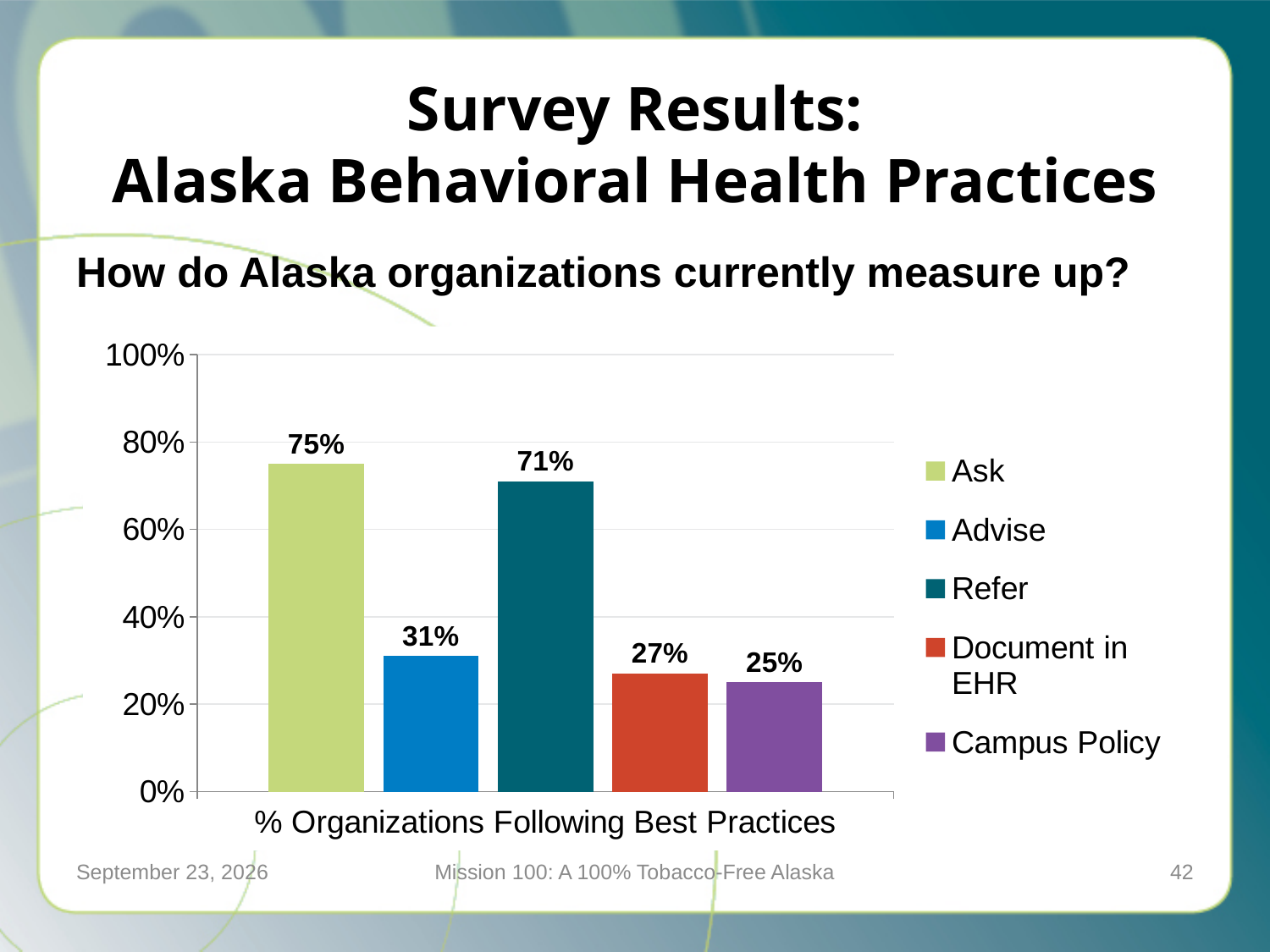
What is the value shown for Advise? 31% What percentage of organizations follow the Ask best practice? 75% Which best practice has the highest percentage of organizations following it? Ask How many series does the legend list? 5 What is the label on the x axis of the chart? % Organizations Following Best Practices What is the value shown for Document in EHR? 27% What is the value shown for Refer? 71% What is the difference between the values for Ask and Refer? 4% Which is larger, the value for Advise or the value for Document in EHR? Advise Which best practice has the lowest percentage of organizations following it? Campus Policy What is the value shown for Campus Policy? 25% What kind of chart is shown on the slide? Bar chart